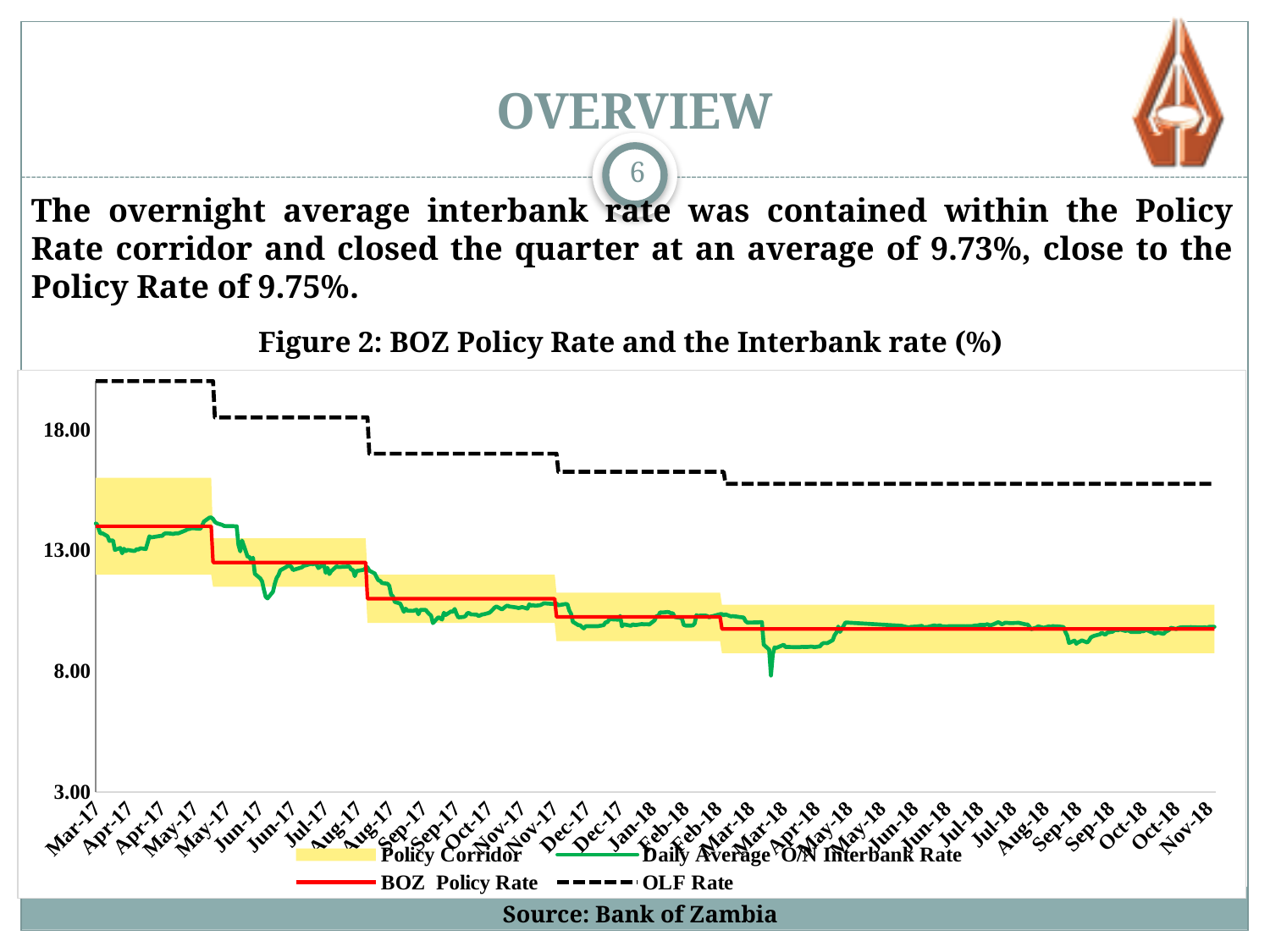
In Nov-18, which is higher: the OLF Rate or the BOZ Policy Rate? OLF Rate How many series does the legend of Figure 2 list? 4 Is the BOZ Policy Rate in Nov-18 greater or less than 13.00? less Does the BOZ Policy Rate rise or fall from Mar-17 to Nov-18? fall What is the title of the chart on the slide? Figure 2: BOZ Policy Rate and the Interbank rate (%) Does the OLF Rate rise or fall from Mar-17 to Nov-18? fall Which series in Figure 2 is drawn as a black dashed line? OLF Rate Is the OLF Rate in Mar-17 greater or less than 18.00? greater Is the OLF Rate in Nov-18 greater or less than 13.00? greater What kind of chart is Figure 2? line chart Is the BOZ Policy Rate higher in Mar-17 or in Nov-18? Mar-17